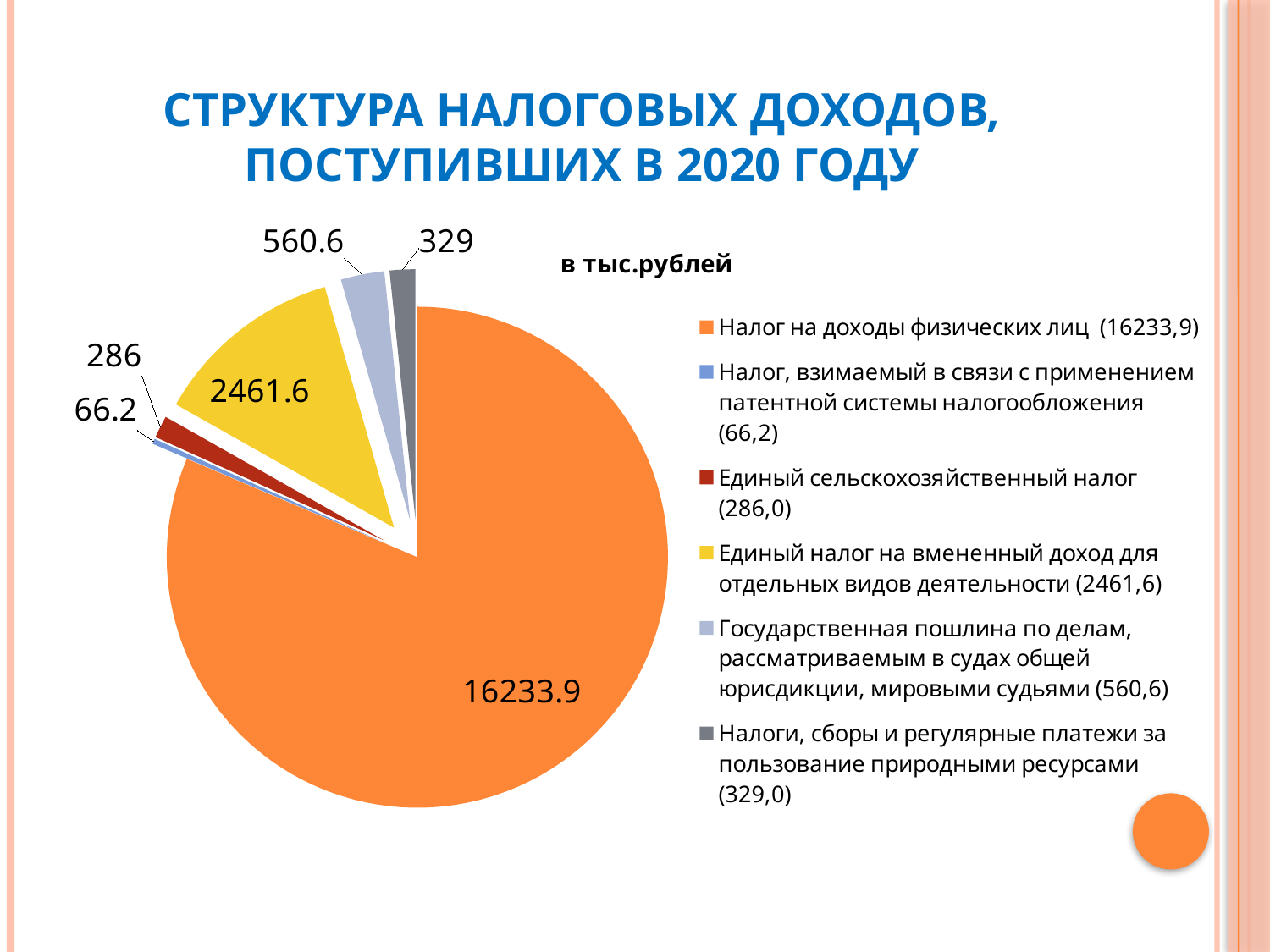
What is the value of the slice for Единый налог на вмененный доход для отдельных видов деятельности? 2461.6 What colour is the slice for Единый налог на вмененный доход для отдельных видов деятельности? yellow How many slices does the pie chart have? 6 What is the value of the slice for Налоги, сборы и регулярные платежи за пользование природными ресурсами? 329 What unit of measurement is stated for the values in the pie chart? тыс.рублей What is the value of the slice for Единый сельскохозяйственный налог? 286 What is the difference between the values for Единый налог на вмененный доход and Государственная пошлина по делам, рассматриваемым в судах общей юрисдикции? 1901 What is the value of the slice for Налог на доходы физических лиц? 16233.9 Which is larger: the slice for Единый сельскохозяйственный налог or the slice for Налоги, сборы и регулярные платежи за пользование природными ресурсами? Налоги, сборы и регулярные платежи за пользование природными ресурсами What kind of chart is shown on the slide? pie chart Which category has the smallest slice in the pie chart? Налог, взимаемый в связи с применением патентной системы налогообложения Which category has the largest slice in the pie chart? Налог на доходы физических лиц